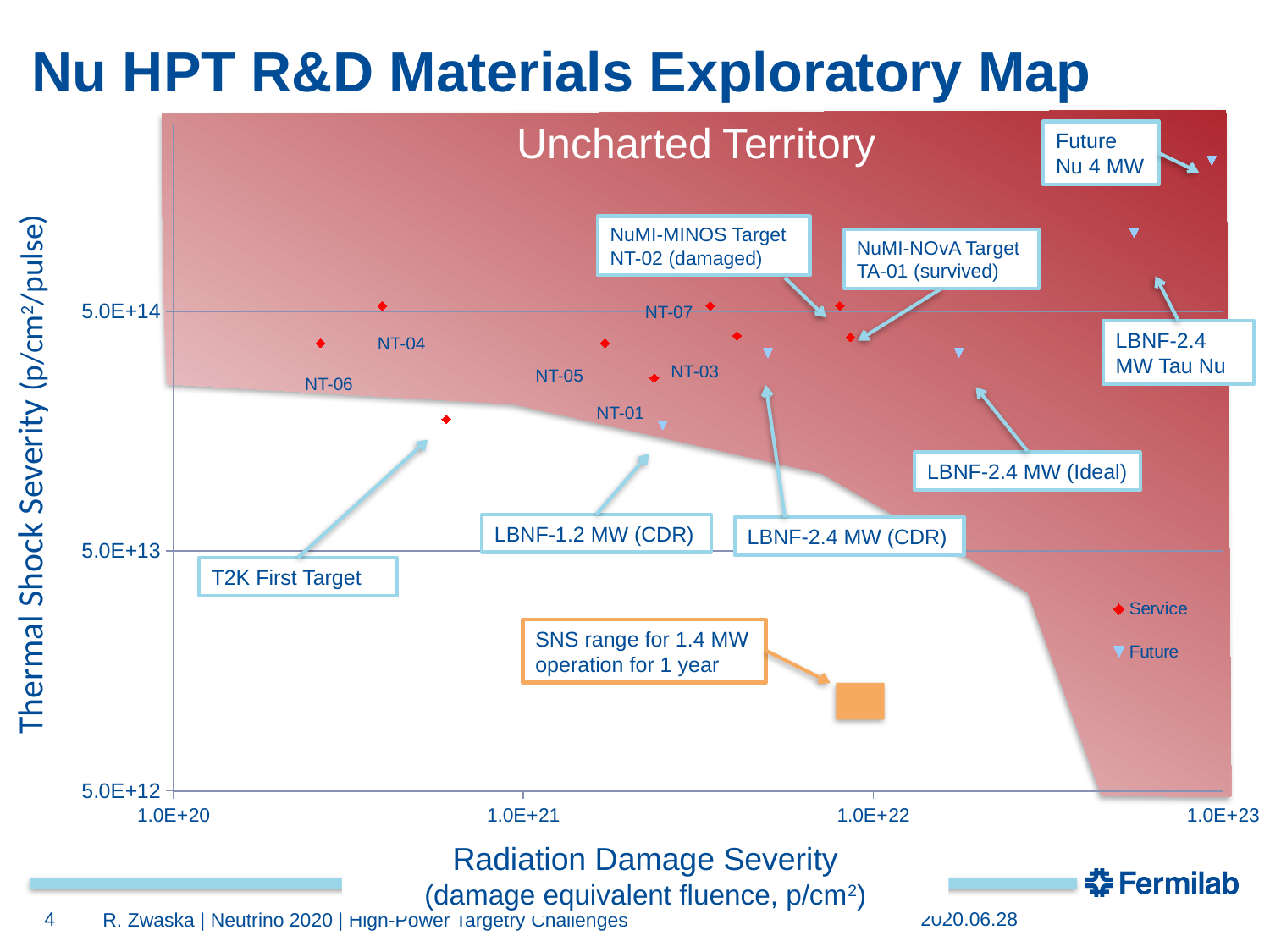
Is the Thermal Shock Severity value for the T2K First Target point greater or less than 5.0E+13? greater What are the two series named in the chart legend? Service and Future Which has the higher Thermal Shock Severity, the Future Nu 4 MW point or the T2K First Target point? Future Nu 4 MW What is the title of the chart's x axis? Radiation Damage Severity (damage equivalent fluence, p/cm2) Which labeled point has the highest Thermal Shock Severity? Future Nu 4 MW Is the Radiation Damage Severity value for the NT-04 point greater or less than 1.0E+21? less Is the Thermal Shock Severity value for the Future Nu 4 MW point greater or less than 5.0E+14? greater What kind of chart is shown on the slide? scatter chart Which has the higher Radiation Damage Severity, the LBNF-2.4 MW (Ideal) point or the LBNF-1.2 MW (CDR) point? LBNF-2.4 MW (Ideal) How many series does the chart legend list? 2